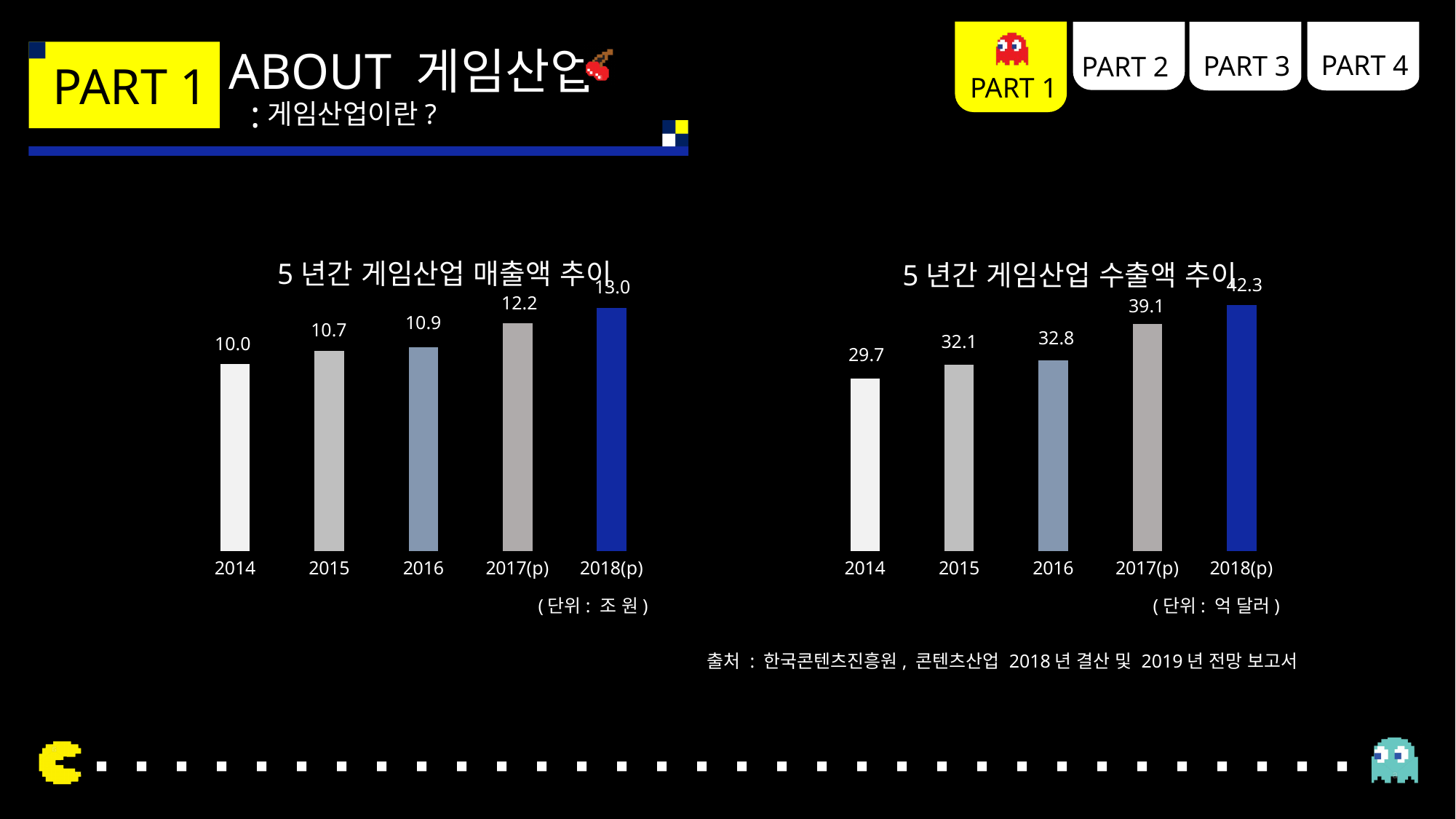
In the left chart (5 년간 게임산업 매출액 추이), what is the value for 2016? 10.9 How many bars are in the left chart (5 년간 게임산업 매출액 추이)? 5 In the left chart (5 년간 게임산업 매출액 추이), which year has the highest value? 2018(p) What is the title of the left chart? 5 년간 게임산업 매출액 추이 In the right chart (5 년간 게임산업 수출액 추이), which is larger, the value for 2015 or the value for 2016? 2016 In the left chart (5 년간 게임산업 매출액 추이), do the values rise or fall from 2014 to 2018(p)? rise What unit is shown for the right chart (5 년간 게임산업 수출액 추이)? 억 달러 In the right chart (5 년간 게임산업 수출액 추이), what is the value for 2017(p)? 39.1 In the left chart (5 년간 게임산업 매출액 추이), what is the difference between the 2018(p) and 2014 values? 3.0 What kind of chart is the right chart (5 년간 게임산업 수출액 추이)? bar chart In the right chart (5 년간 게임산업 수출액 추이), what is the difference between the 2018(p) and 2017(p) values? 3.2 In the right chart (5 년간 게임산업 수출액 추이), which year has the lowest value? 2014